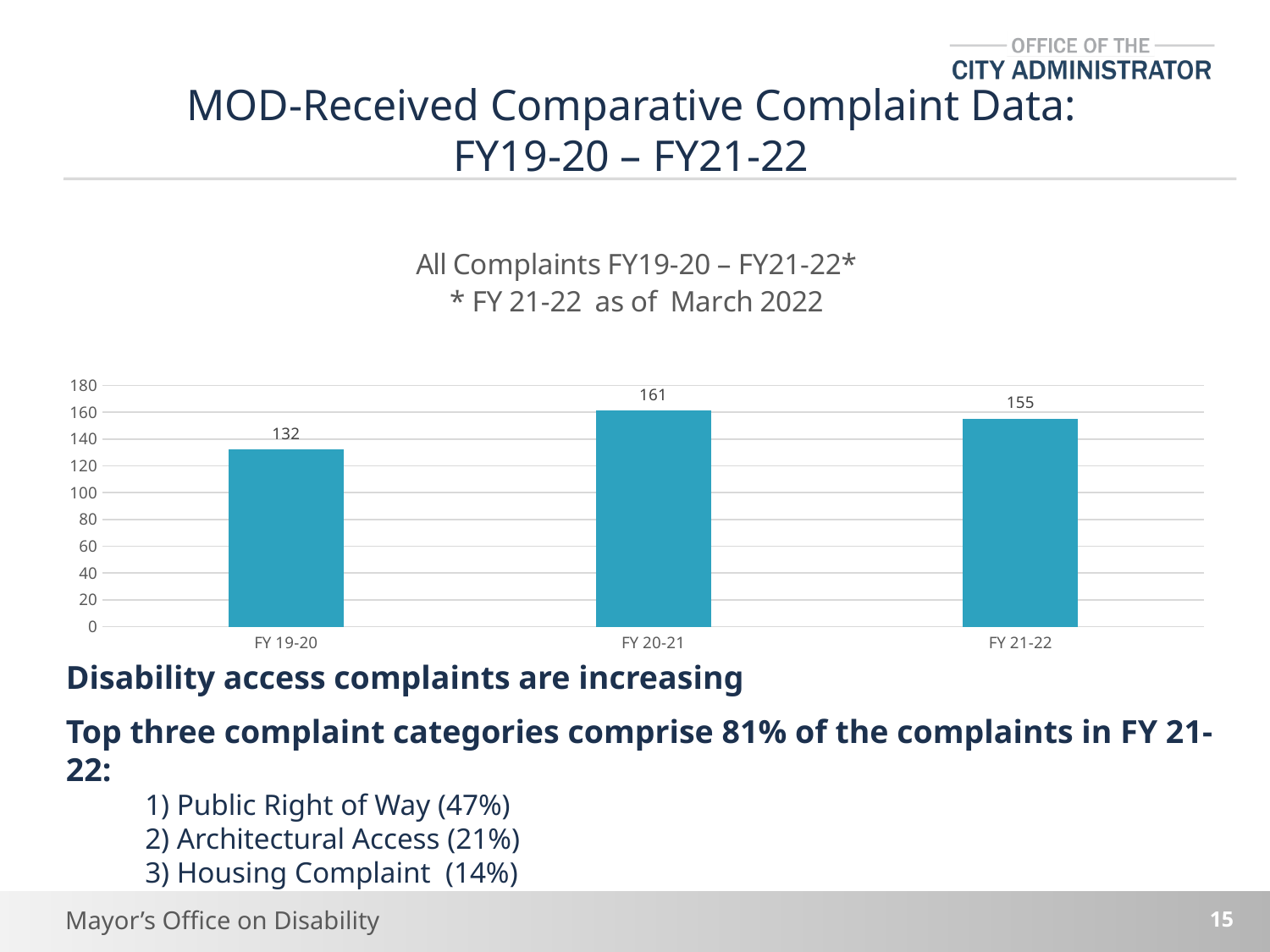
What is the value for FY 20-21? 161 What is the difference between the values for FY 20-21 and FY 19-20? 29 Which fiscal year has the highest number of complaints? FY 20-21 What is the title of the chart? All Complaints FY19-20 – FY21-22* What kind of chart is shown on the slide? bar chart What is the value for FY 21-22? 155 Is the value for FY 19-20 greater or less than 140? less Which fiscal year has the lowest number of complaints? FY 19-20 What is the difference between the values for FY 20-21 and FY 21-22? 6 What is the value for FY 19-20? 132 Which is larger, the value for FY 19-20 or the value for FY 21-22? FY 21-22 How many fiscal years are shown on the chart? 3